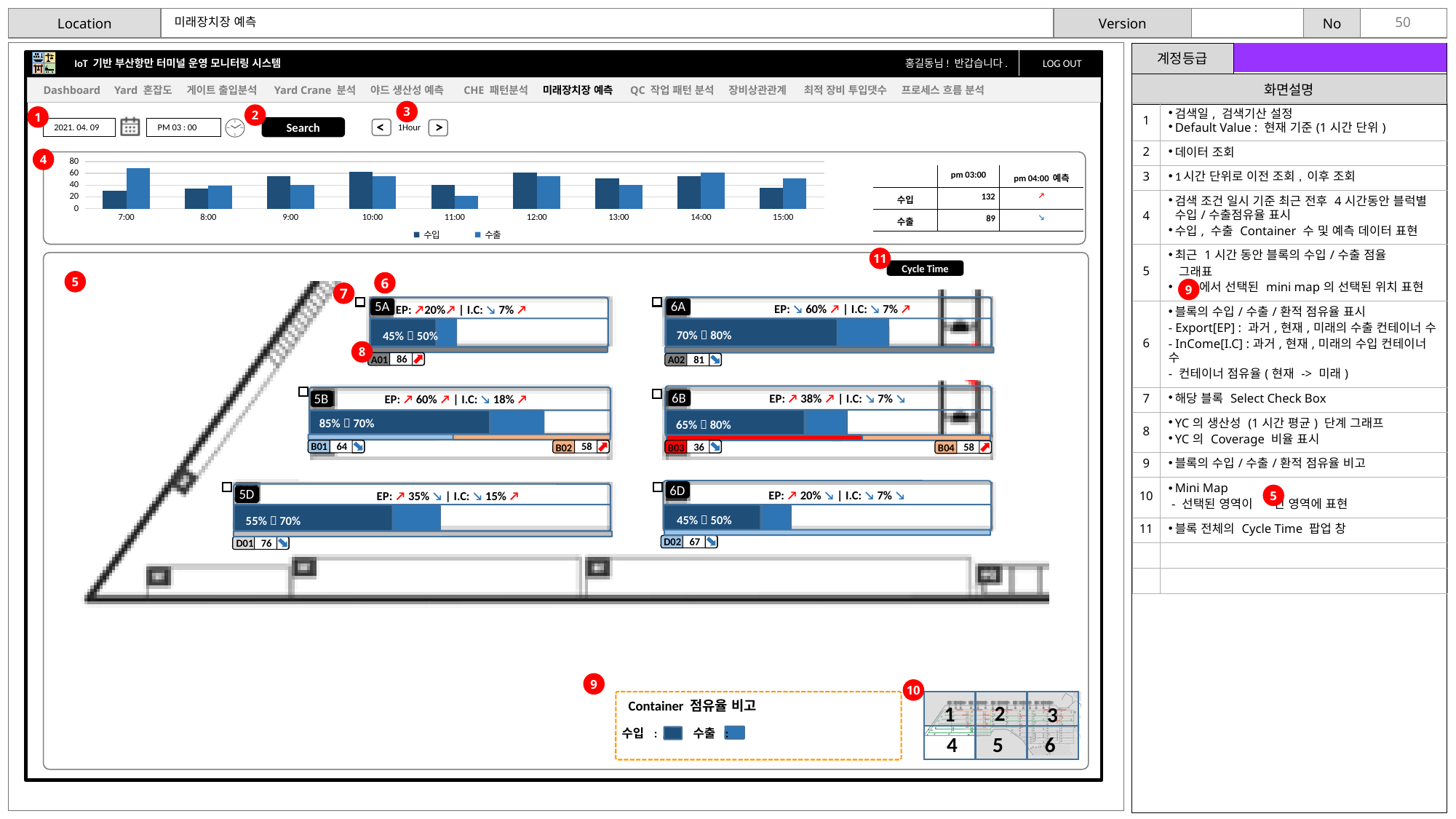
How many series does the legend of the top bar chart list? 2 What is the first time label on the x axis of the top bar chart? 7:00 In the top bar chart, at which time is the 수출 bar highest? 7:00 In the top bar chart, is the 수출 value at 7:00 greater or less than 60? greater What are the two legend entries of the top bar chart? 수입, 수출 In the top bar chart, at which time is the 수출 bar lowest? 11:00 In the top bar chart, is the 수출 value at 11:00 greater or less than 40? less What kind of chart is shown at the top of the slide (item 4)? bar chart How many time categories are shown on the x axis of the top bar chart? 9 In the top bar chart, is the 수입 value at 7:00 greater or less than 40? less In the top bar chart, at 7:00 which series has the larger value, 수입 or 수출? 수출 In the top bar chart, at 11:00 which series has the larger value, 수입 or 수출? 수입